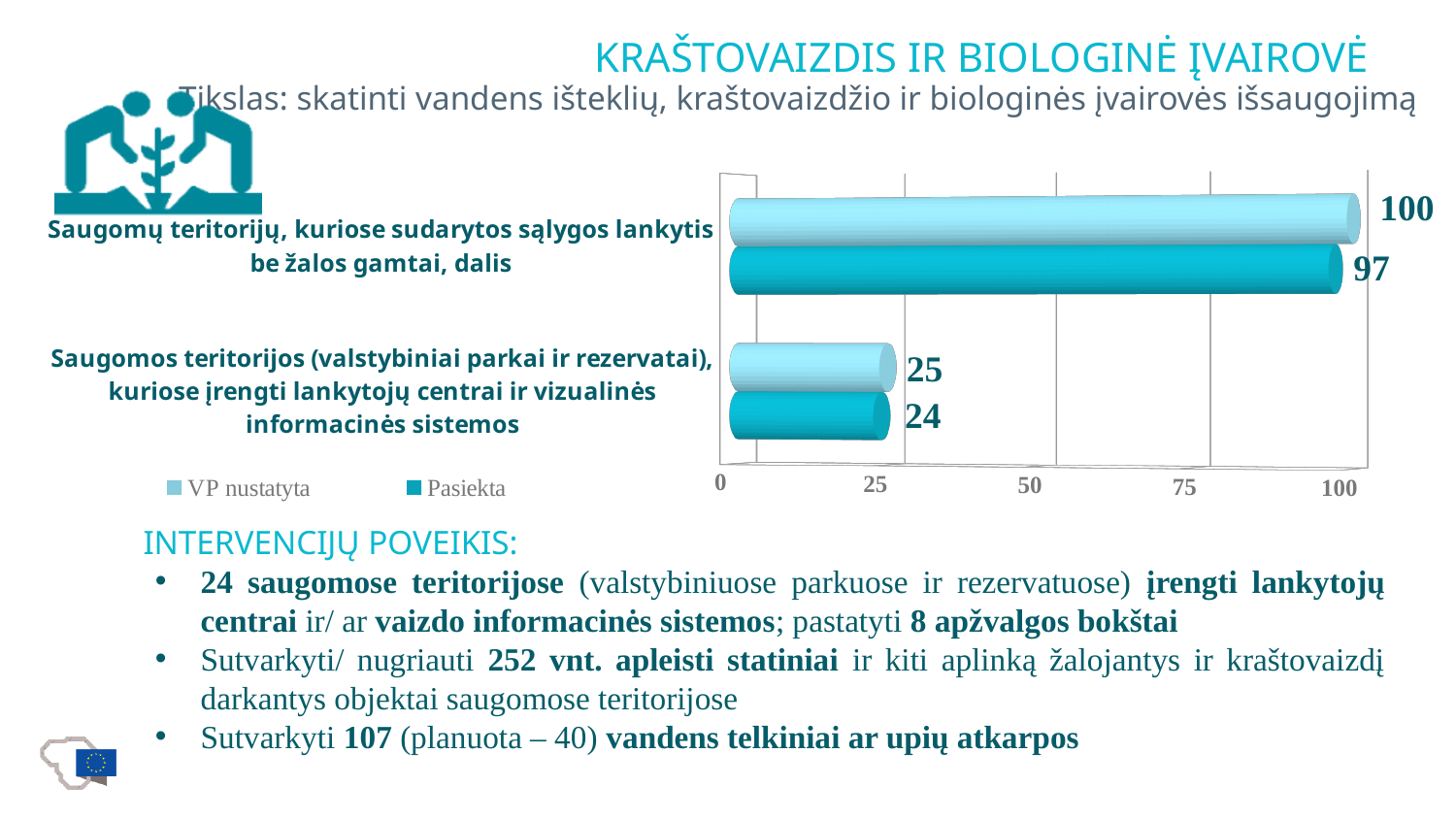
What is the 'Pasiekta' value for 'Saugomų teritorijų, kuriose sudarytos sąlygos lankytis be žalos gamtai, dalis'? 97 What is the 'VP nustatyta' value for 'Saugomų teritorijų, kuriose sudarytos sąlygos lankytis be žalos gamtai, dalis'? 100 What is the difference between the 'VP nustatyta' and 'Pasiekta' values for 'Saugomų teritorijų, kuriose sudarytos sąlygos lankytis be žalos gamtai, dalis'? 3 What type of chart is shown on the slide? bar chart What is the 'Pasiekta' value for 'Saugomos teritorijos (valstybiniai parkai ir rezervatai), kuriose įrengti lankytojų centrai ir vizualinės informacinės sistemos'? 24 What is the difference between the 'VP nustatyta' and 'Pasiekta' values for 'Saugomos teritorijos (valstybiniai parkai ir rezervatai), kuriose įrengti lankytojų centrai ir vizualinės informacinės sistemos'? 1 Which category has the highest 'Pasiekta' value? Saugomų teritorijų, kuriose sudarytos sąlygos lankytis be žalos gamtai, dalis What are the two legend entries of the chart? VP nustatyta and Pasiekta How many series does the chart legend list? 2 What is the 'VP nustatyta' value for 'Saugomos teritorijos (valstybiniai parkai ir rezervatai), kuriose įrengti lankytojų centrai ir vizualinės informacinės sistemos'? 25 How many categories are plotted in the chart? 2 Which is larger: the 'VP nustatyta' value for 'Saugomų teritorijų, kuriose sudarytos sąlygos lankytis be žalos gamtai, dalis' or the 'VP nustatyta' value for 'Saugomos teritorijos (valstybiniai parkai ir rezervatai), kuriose įrengti lankytojų centrai ir vizualinės informacinės sistemos'? Saugomų teritorijų, kuriose sudarytos sąlygos lankytis be žalos gamtai, dalis